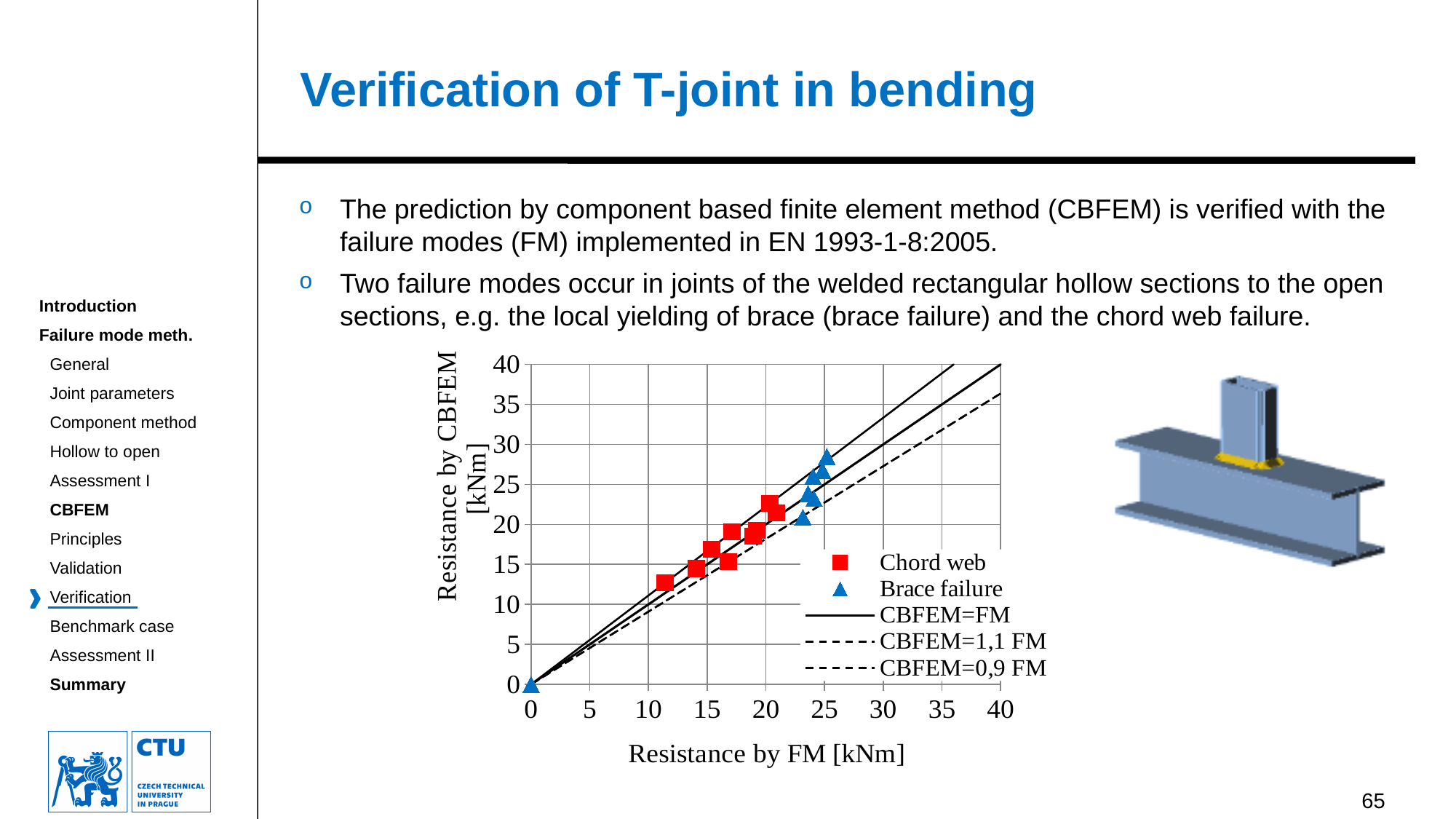
How many entries does the chart legend list? 5 Which series in the chart is plotted with blue triangles? Brace failure Which series has the points with the higher Resistance by FM values, Chord web or Brace failure? Brace failure Is the lowest Chord web point on the y axis greater or less than 15 kNm? less What kind of chart is shown on the slide? Scatter chart Is the highest Brace failure point on the y axis greater or less than 25 kNm? greater What is the maximum value shown on the x axis of the chart? 40 What is the label of the y axis of the chart? Resistance by CBFEM [kNm] Are the Brace failure points located at x values greater or less than 20 kNm? greater Which marker shape and colour represent the Chord web series in the chart? Red squares Which legend entry corresponds to the solid line in the chart? CBFEM=FM What is the label of the x axis of the chart? Resistance by FM [kNm]